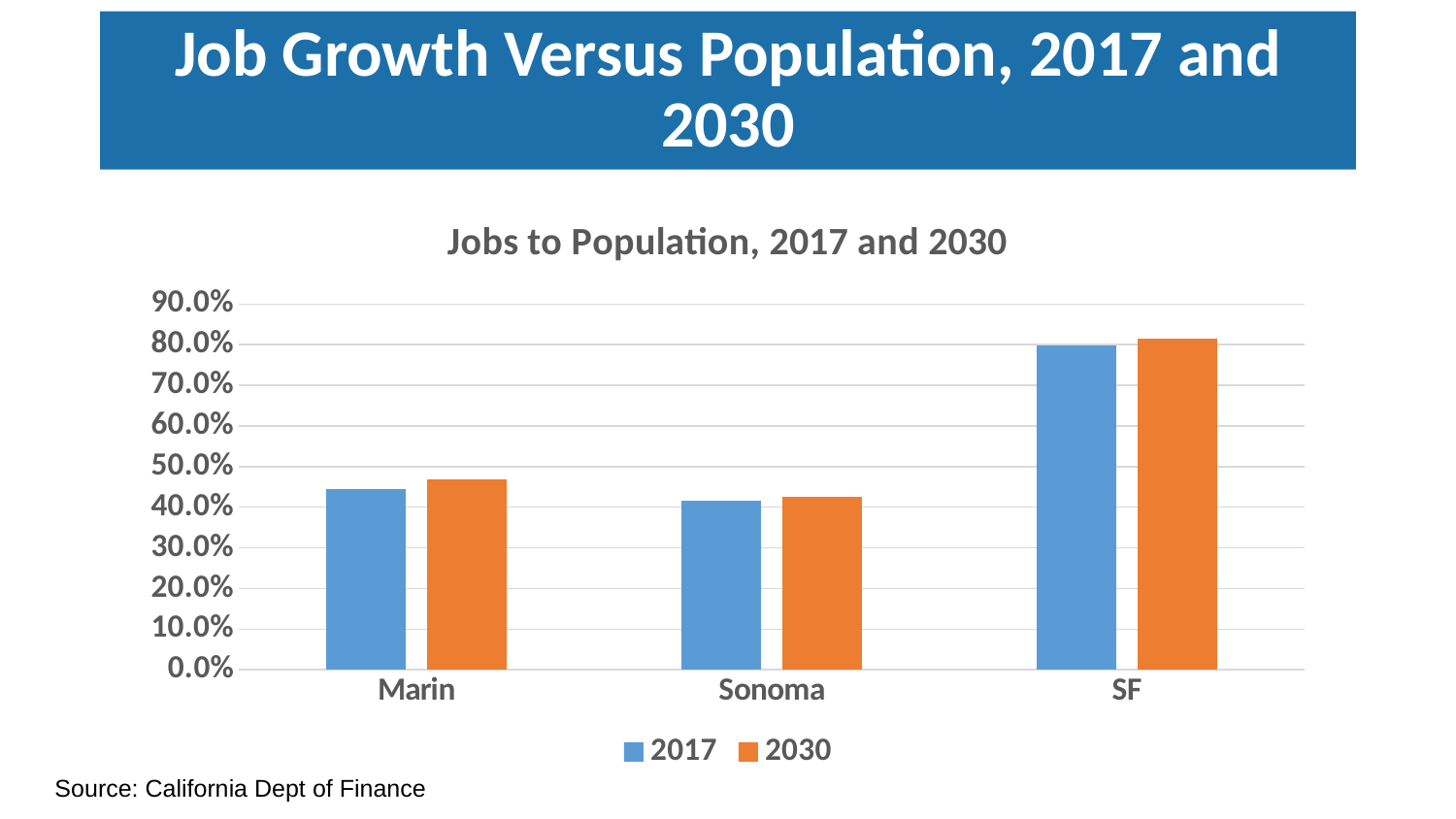
How many categories are shown on the x axis of the chart? 3 Which is larger, the 2017 value for SF or the 2017 value for Marin? SF How many series does the chart's legend list? 2 What are the two series listed in the chart's legend? 2017 and 2030 Which category has the lowest value for the 2030 series? Sonoma Which category has the highest value for the 2017 series? SF Which is larger, the 2030 value for Marin or the 2030 value for Sonoma? Marin Is the 2017 value for SF greater or less than 70.0%? greater What kind of chart is shown on the slide? bar chart Is the 2030 value for Sonoma greater or less than 40.0%? greater Is the 2017 value for Marin greater or less than 50.0%? less What is the title of the chart? Jobs to Population, 2017 and 2030